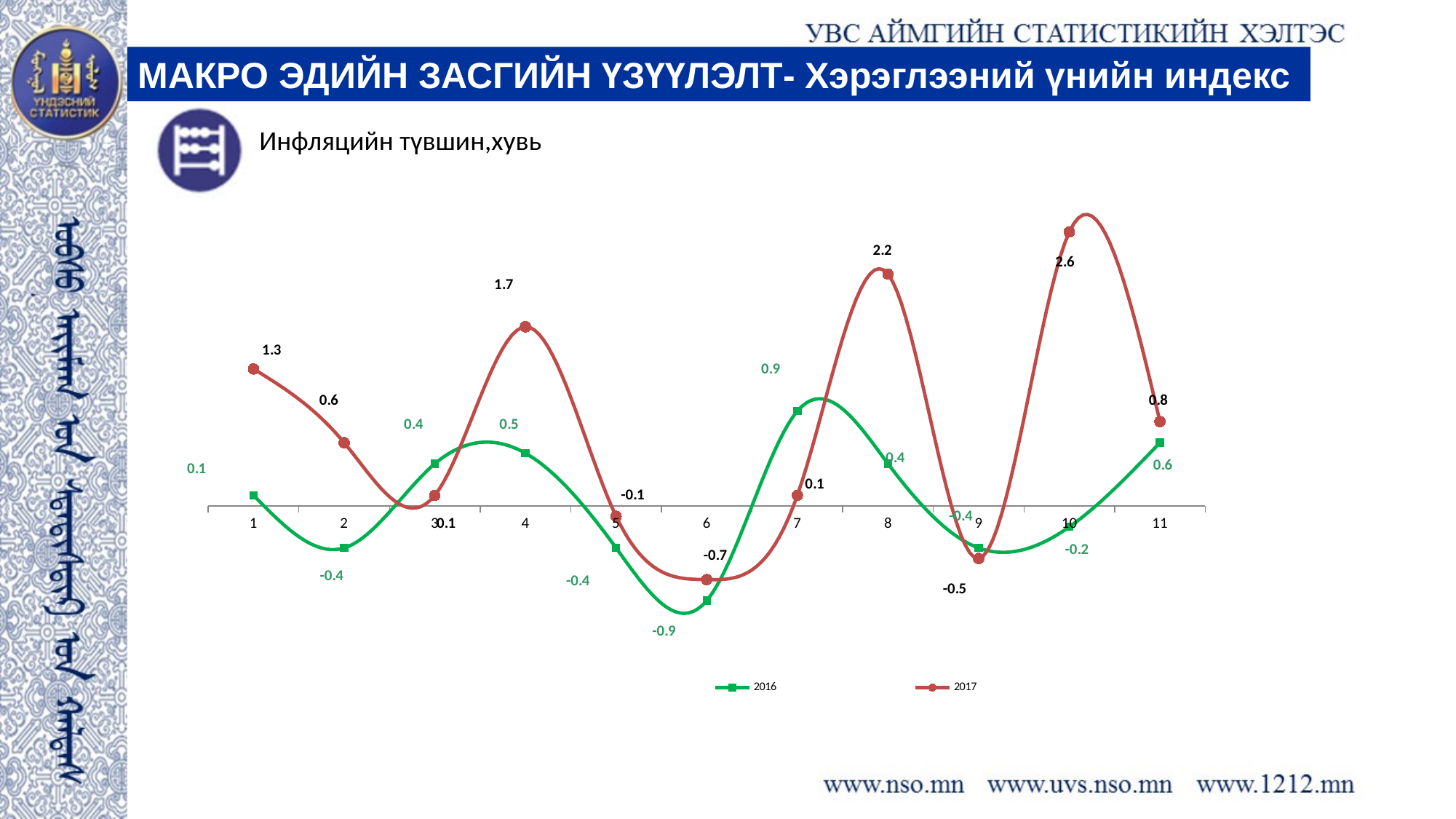
How many series does the legend list? 2 At which month is the 2016 series lowest? 6 What is the value for 2017 at month 10? 2.6 How many months are plotted on the x axis? 11 At which month is the 2017 series highest? 10 What is the subtitle shown above the chart? Инфляцийн түвшин,хувь What is the value for 2016 at month 6? -0.9 Which series has the larger value at month 1, 2016 or 2017? 2017 What is the value for 2017 at month 4? 1.7 What is the value for 2016 at month 7? 0.9 What type of chart is shown on the slide? line chart What is the difference between the 2017 and 2016 values at month 8? 1.8